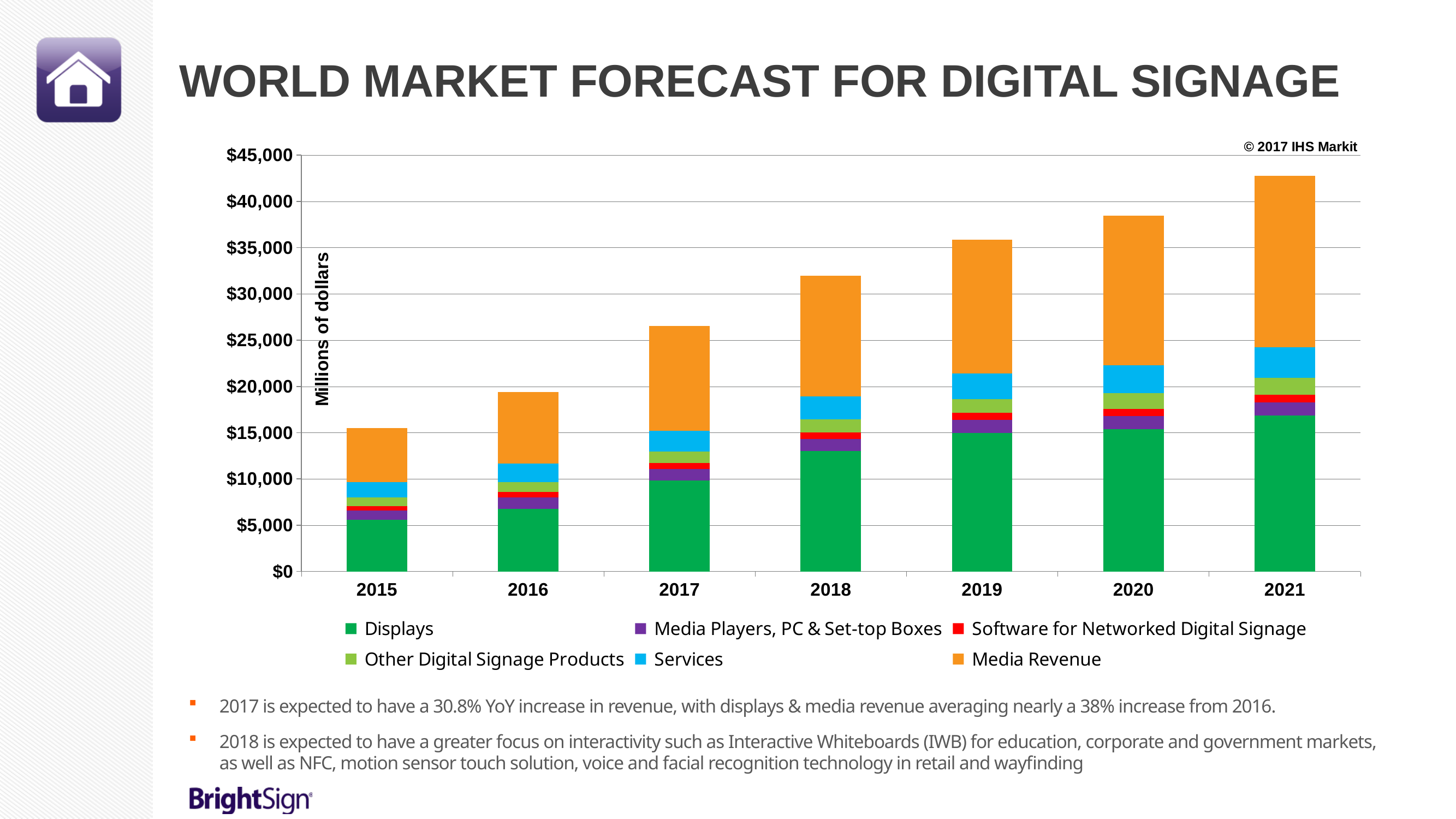
What is the label on the chart's vertical axis? Millions of dollars How many years are shown along the x axis of the chart? 7 How many series does the chart's legend list? 6 Do the total bar heights rise or fall from 2015 to 2021? Rise Which year has the lowest total bar? 2015 Which year has the highest total bar? 2021 Is the total bar for 2021 greater or less than $40,000? greater Is the total bar for 2018 greater or less than $30,000? greater Is the Displays segment for 2021 greater or less than $15,000? greater Which is larger, the total bar for 2017 or the total bar for 2020? 2020 What kind of chart is shown on the slide? Stacked bar chart